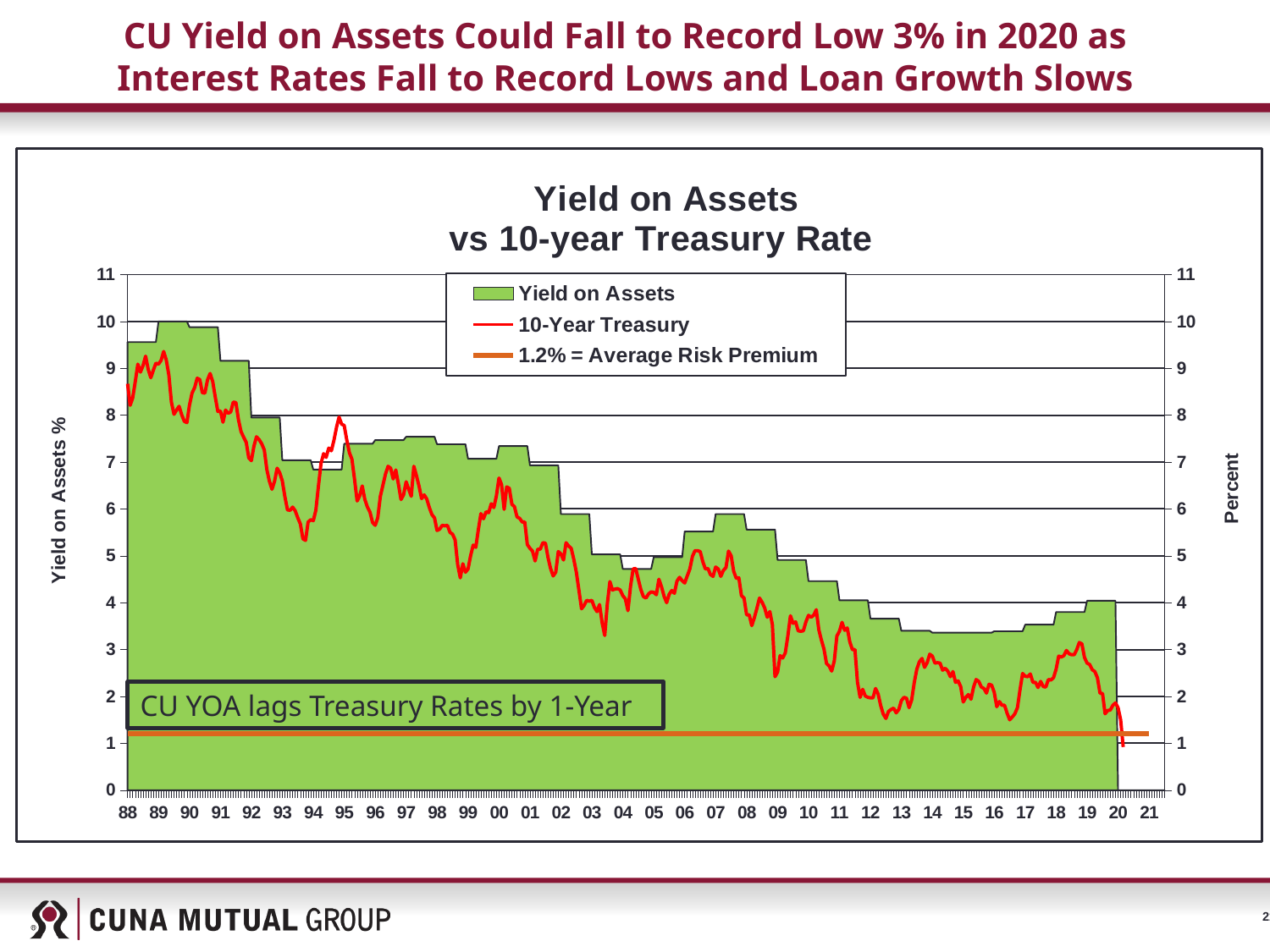
In 2012, which is higher: Yield on Assets or the 10-Year Treasury? Yield on Assets Is the Yield on Assets value for 1990 greater or less than 9? greater Is the Yield on Assets value for 2008 greater or less than 5? greater Is the 10-Year Treasury value for 1988 greater or less than 7? greater What value does the legend give for the Average Risk Premium line? 1.2% What is the highest value shown on the left y axis? 11 How many year labels are shown on the x axis? 34 What is the title of the chart? Yield on Assets vs 10-year Treasury Rate Overall, does the Yield on Assets rise or fall from 1988 to 2019? fall How many series does the chart legend list? 3